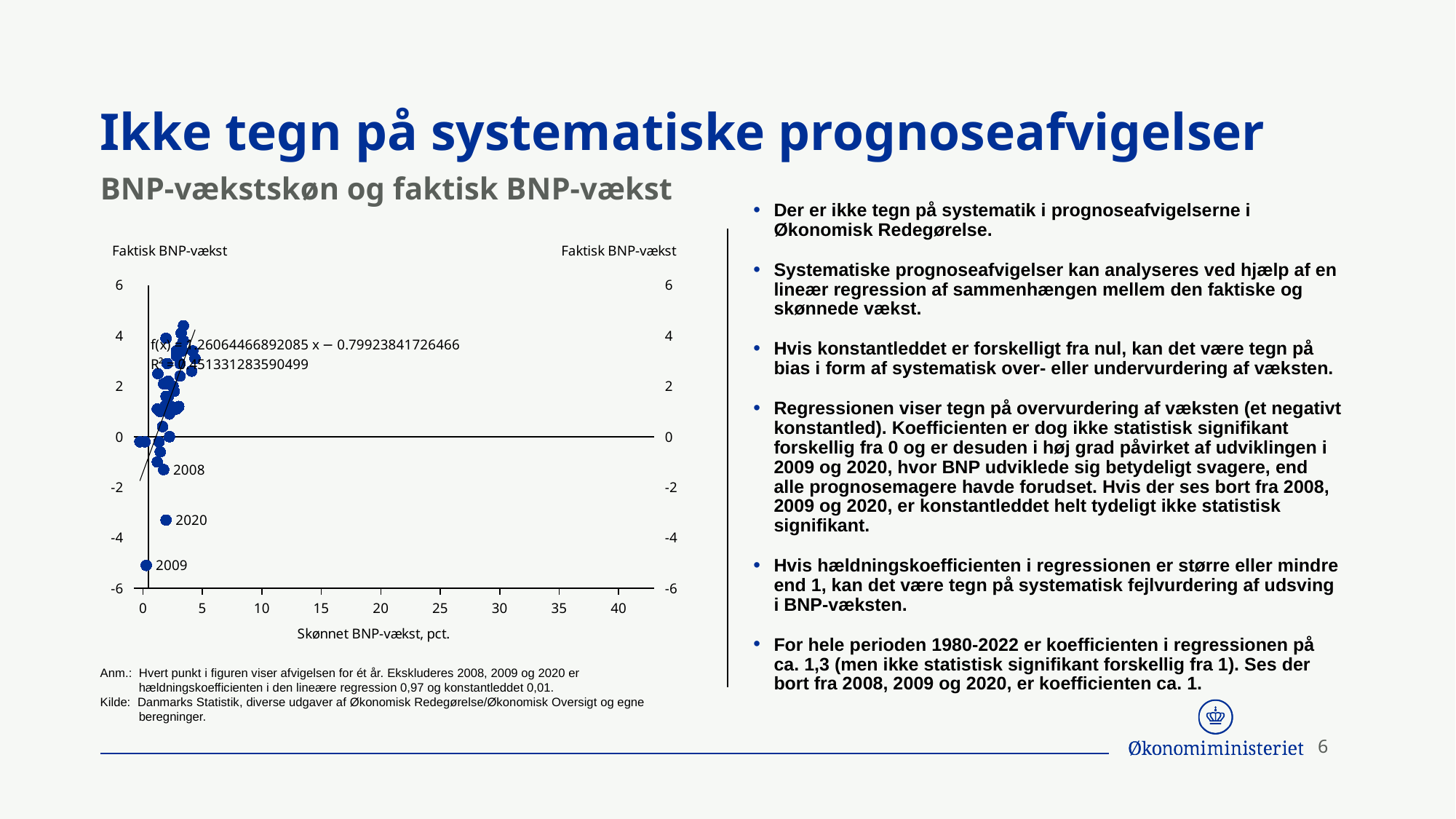
Is the actual GDP growth value for the point labelled 2008 greater or less than 0? less Is the actual GDP growth value for the point labelled 2020 greater or less than -2? less What is the label of the horizontal axis of the chart? Skønnet BNP-vækst, pct. Which labelled year has the lowest actual GDP growth (Faktisk BNP-vækst) in the chart? 2009 Is the actual GDP growth value for the point labelled 2020 greater or less than -4? greater How many points in the chart are labelled with a year? 3 What kind of chart is shown on the slide? Scatter chart Which of the points labelled 2009 and 2020 has the higher actual GDP growth? 2020 What is the highest tick value shown on the horizontal axis of the chart? 40